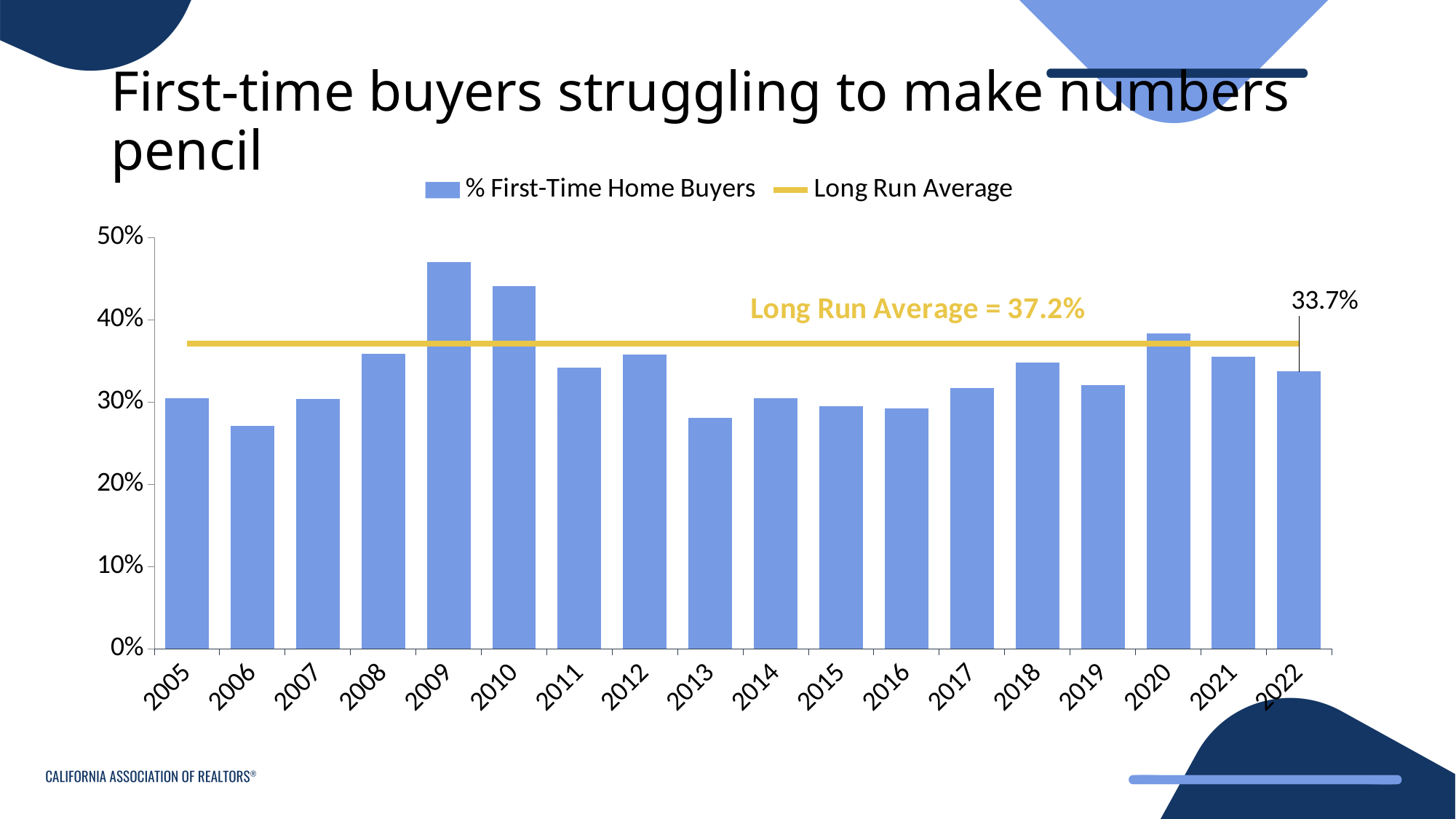
By how many percentage points is the 2022 value below the Long Run Average? 3.5 percentage points Which year has the highest share of first-time home buyers? 2009 Is the value for 2006 greater or less than 30%? less Is the value for 2009 greater or less than 40%? greater Which year has a higher share of first-time home buyers, 2009 or 2010? 2009 How many series does the legend list? 2 How many years are shown on the x axis? 18 What kind of chart is used to show the % First-Time Home Buyers? Bar chart What is the Long Run Average shown on the chart? 37.2% Which year has a higher share of first-time home buyers, 2020 or 2021? 2020 What is the value for % First-Time Home Buyers in 2022? 33.7% Do the values rise or fall from 2020 to 2022? Fall